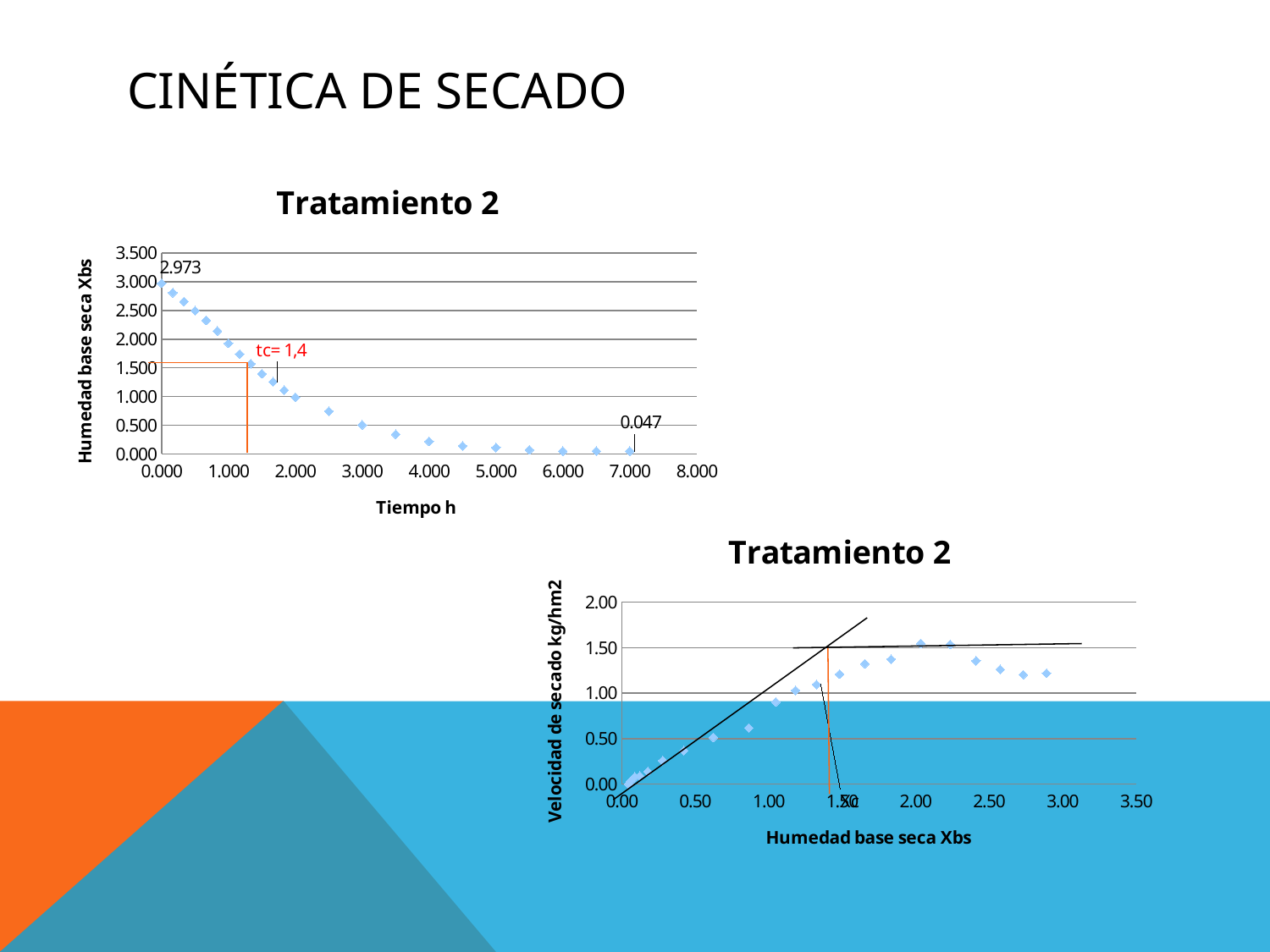
In the bottom chart (Velocidad de secado vs Humedad base seca Xbs), is the value at Xbs of about 1.50 greater or less than 1.00? greater What type of chart is the top chart on the slide? scatter chart In the top chart, what is the difference between the labelled values at time 0.000 and time 7.000? 2.926 What type of chart is the bottom chart on the slide? scatter chart In the bottom chart (Velocidad de secado vs Humedad base seca Xbs), is the value at Xbs of about 2.90 greater or less than 1.50? less In the top chart, do the values rise or fall as time increases along the x axis? fall In the top chart, what is the value of tc shown in the red annotation? tc= 1,4 What is the x-axis title of the top chart? Tiempo h In the top chart (Humedad base seca Xbs vs Tiempo h), what is the labelled value at time 0.000? 2.973 In the top chart, is the value at time 3.000 greater or less than 1.000? less In the top chart (Humedad base seca Xbs vs Tiempo h), what is the labelled value at time 7.000? 0.047 In the top chart, which is larger: the value at time 0.000 or the value at time 7.000? time 0.000